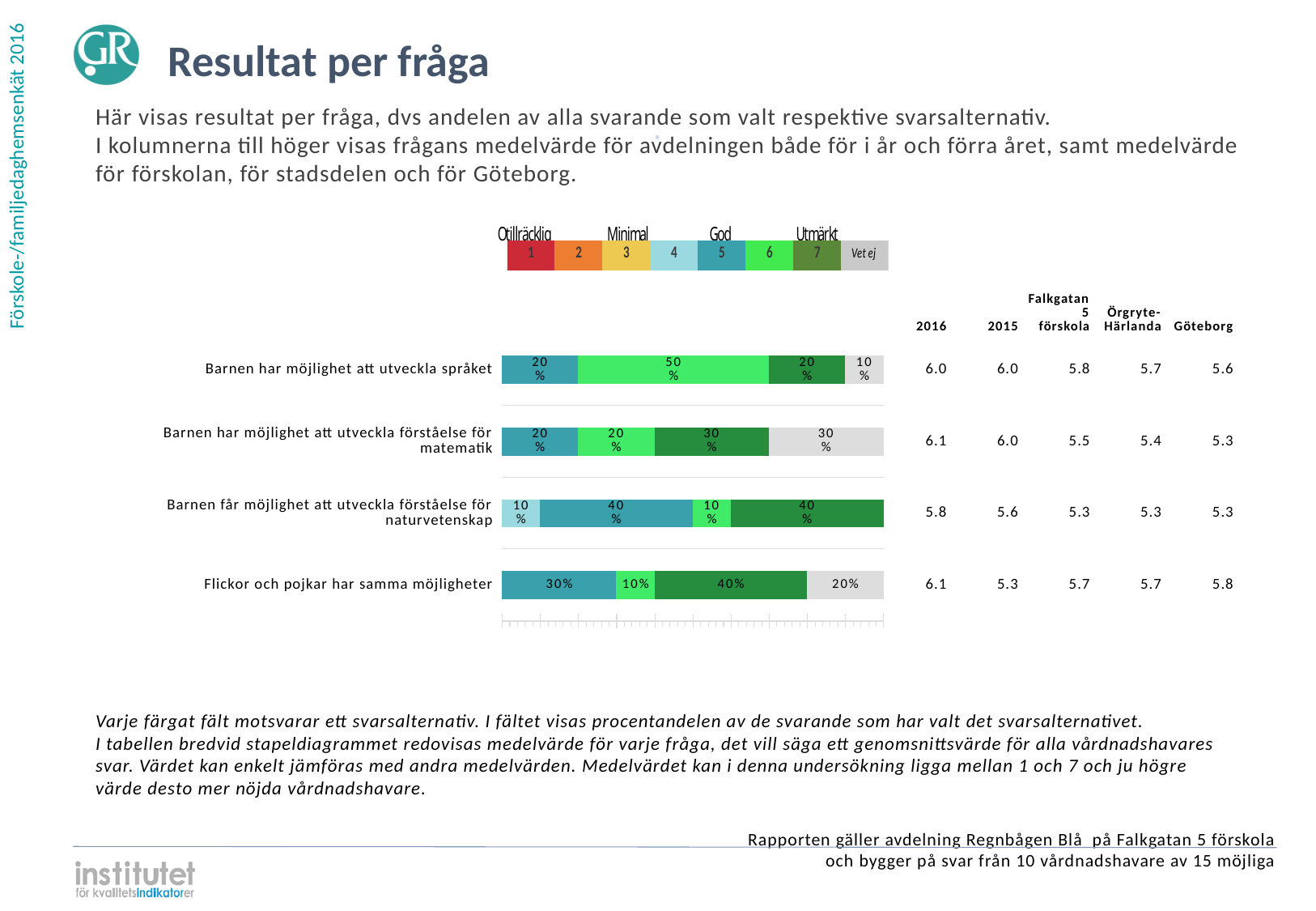
How many answer alternatives does the colour legend above the chart list, including "Vet ej"? 8 What kind of chart is shown on the slide? Stacked bar chart What is the difference between the answer 6 share and the answer 7 share for "Barnen har möjlighet att utveckla språket"? 30 percentage points What share of respondents chose answer 6 (light green) for "Barnen har möjlighet att utveckla språket"? 50% What share of respondents chose "Vet ej" (grey) for "Barnen har möjlighet att utveckla förståelse för matematik"? 30% Which is larger for "Flickor och pojkar har samma möjligheter": the share for answer 5 (teal) or the share for answer 7 (dark green)? Answer 7 (dark green) What share of respondents chose answer 4 (light blue) for "Barnen får möjlighet att utveckla förståelse för naturvetenskap"? 10% For "Barnen får möjlighet att utveckla förståelse för naturvetenskap", what is the combined share of answers 5 and 7? 80% What share of respondents chose answer 7 (dark green) for "Flickor och pojkar har samma möjligheter"? 40% What is the 2016 mean value shown for "Flickor och pojkar har samma möjligheter"? 6.1 How many questions (categories) are plotted in the bar chart? 4 Which question has the largest share of "Vet ej" (grey) responses? Barnen har möjlighet att utveckla förståelse för matematik